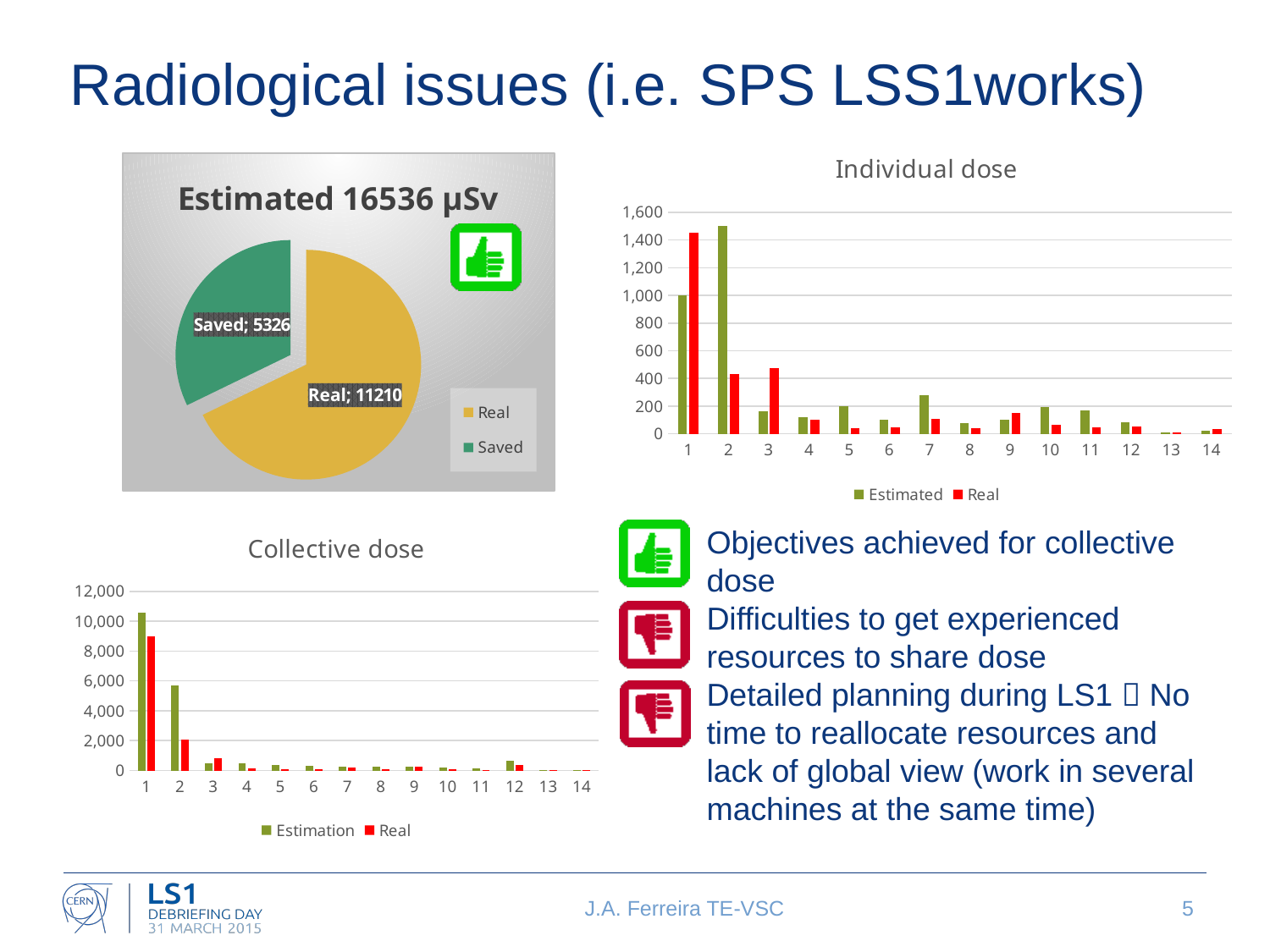
What are the two series listed in the legend of the 'Collective dose' chart? Estimation and Real In the 'Individual dose' chart, is the Real value for category 3 greater or less than 400? greater In the pie chart titled 'Estimated 16536 µSv', what is the value for Real? 11210 In the 'Collective dose' chart, is the Estimation value for category 1 greater or less than 10,000? greater How many categories are shown on the x axis of the 'Individual dose' chart? 14 In the 'Individual dose' chart, which category has the highest Estimated value? 2 What kind of chart is the 'Individual dose' chart? bar chart In the 'Collective dose' chart, which series is larger for category 2, Estimation or Real? Estimation In the pie chart titled 'Estimated 16536 µSv', what is the value for Saved? 5326 In the pie chart titled 'Estimated 16536 µSv', what is the difference between the Real and Saved values? 5884 In the pie chart titled 'Estimated 16536 µSv', which slice is larger, Real or Saved? Real How many series does the legend of the 'Individual dose' chart list? 2